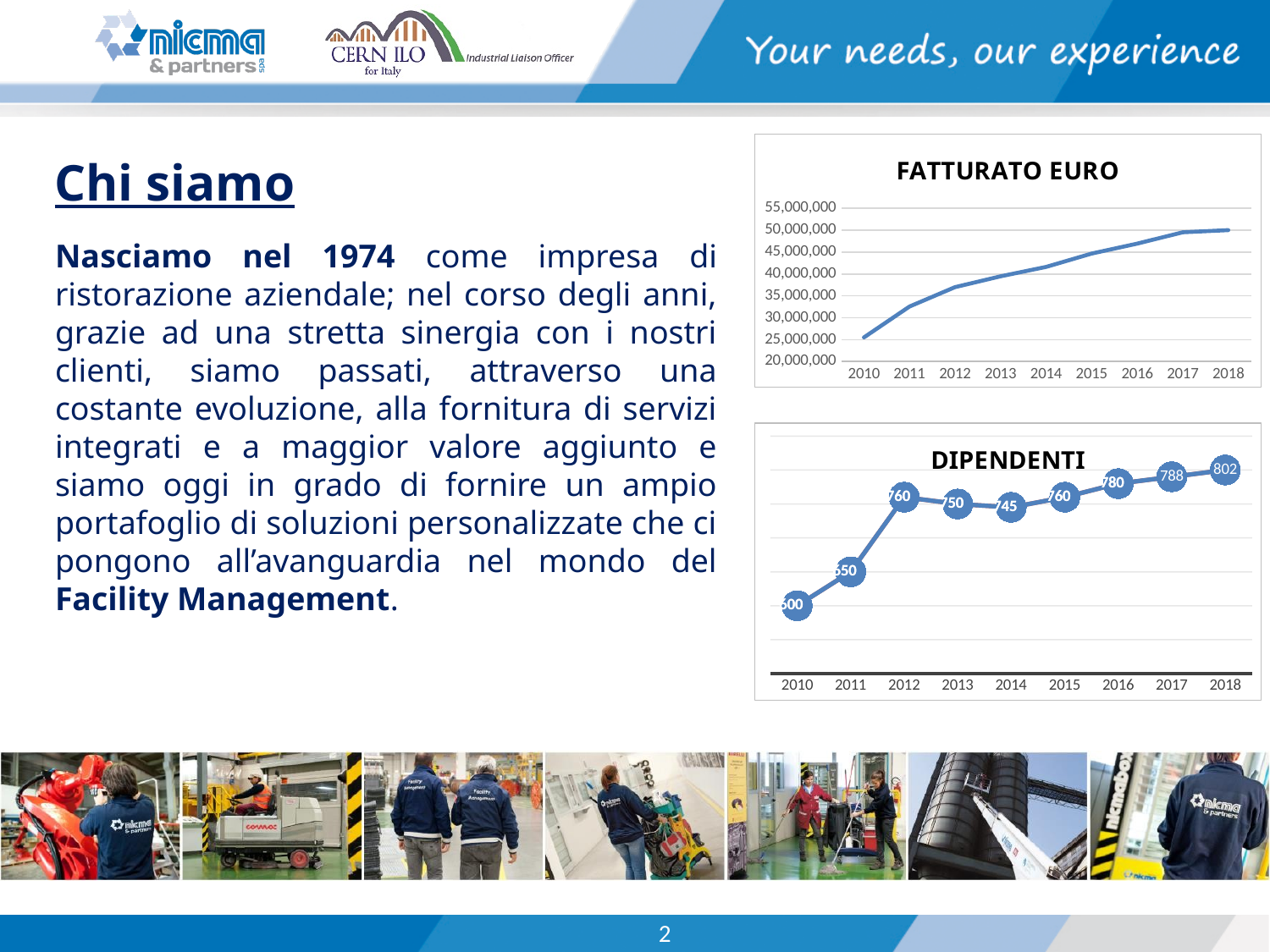
In the FATTURATO EURO chart, is the value for 2012 greater or less than 35,000,000? greater In the DIPENDENTI chart, what is the difference between the values for 2018 and 2010? 202 In the DIPENDENTI chart, what is the value for 2014? 745 What kind of chart is the FATTURATO EURO chart? Line chart In the FATTURATO EURO chart, do the values rise or fall from 2010 to 2018? Rise In the FATTURATO EURO chart, is the value for 2010 greater or less than 30,000,000? less In the DIPENDENTI chart, what is the value for 2010? 600 In the DIPENDENTI chart, which year has the lowest value? 2010 In the DIPENDENTI chart, which year has the highest value? 2018 In the DIPENDENTI chart, which is larger, the value for 2012 or the value for 2013? 2012 In the DIPENDENTI chart, what is the value for 2018? 802 How many years are plotted in the DIPENDENTI chart? 9